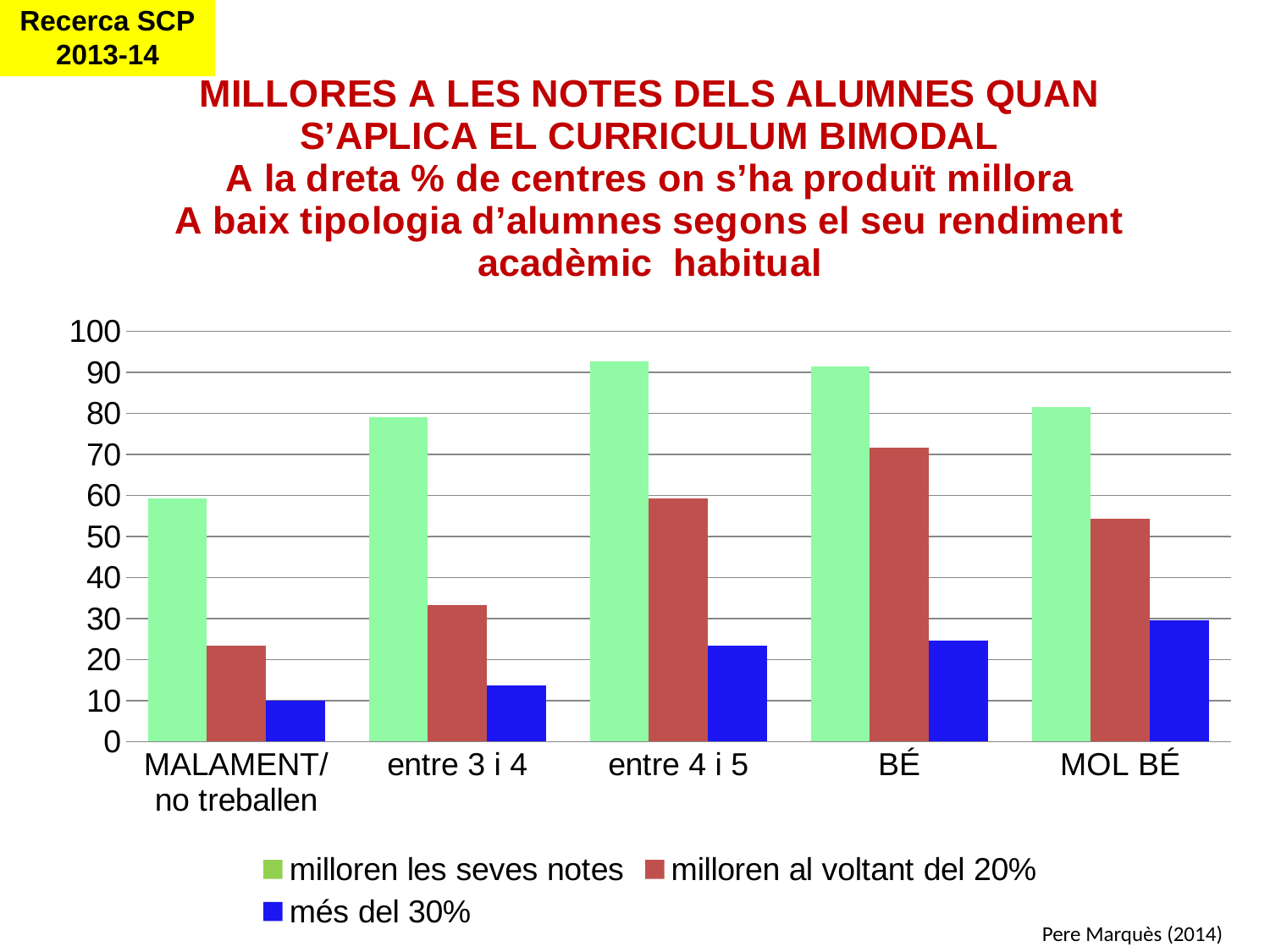
Which category has the lowest value for the series 'milloren les seves notes'? MALAMENT/ no treballen How many series does the chart's legend list? 3 Which category has the highest value for the series 'més del 30%'? MOL BÉ What kind of chart is shown on the slide? bar chart Is the value for 'milloren al voltant del 20%' in the category 'entre 3 i 4' greater or less than 40? less How many categories are shown along the x axis of the chart? 5 Is the value for 'més del 30%' in the category 'MOL BÉ' greater or less than 20? greater For the series 'milloren al voltant del 20%', which is larger: the value for 'BÉ' or the value for 'entre 4 i 5'? BÉ Which colour represents the series 'més del 30%' in the chart? blue Which category has the highest value for the series 'milloren al voltant del 20%'? BÉ Is the value for 'milloren les seves notes' in the category 'MALAMENT/ no treballen' greater or less than 50? greater Which category has the lowest value for the series 'més del 30%'? MALAMENT/ no treballen